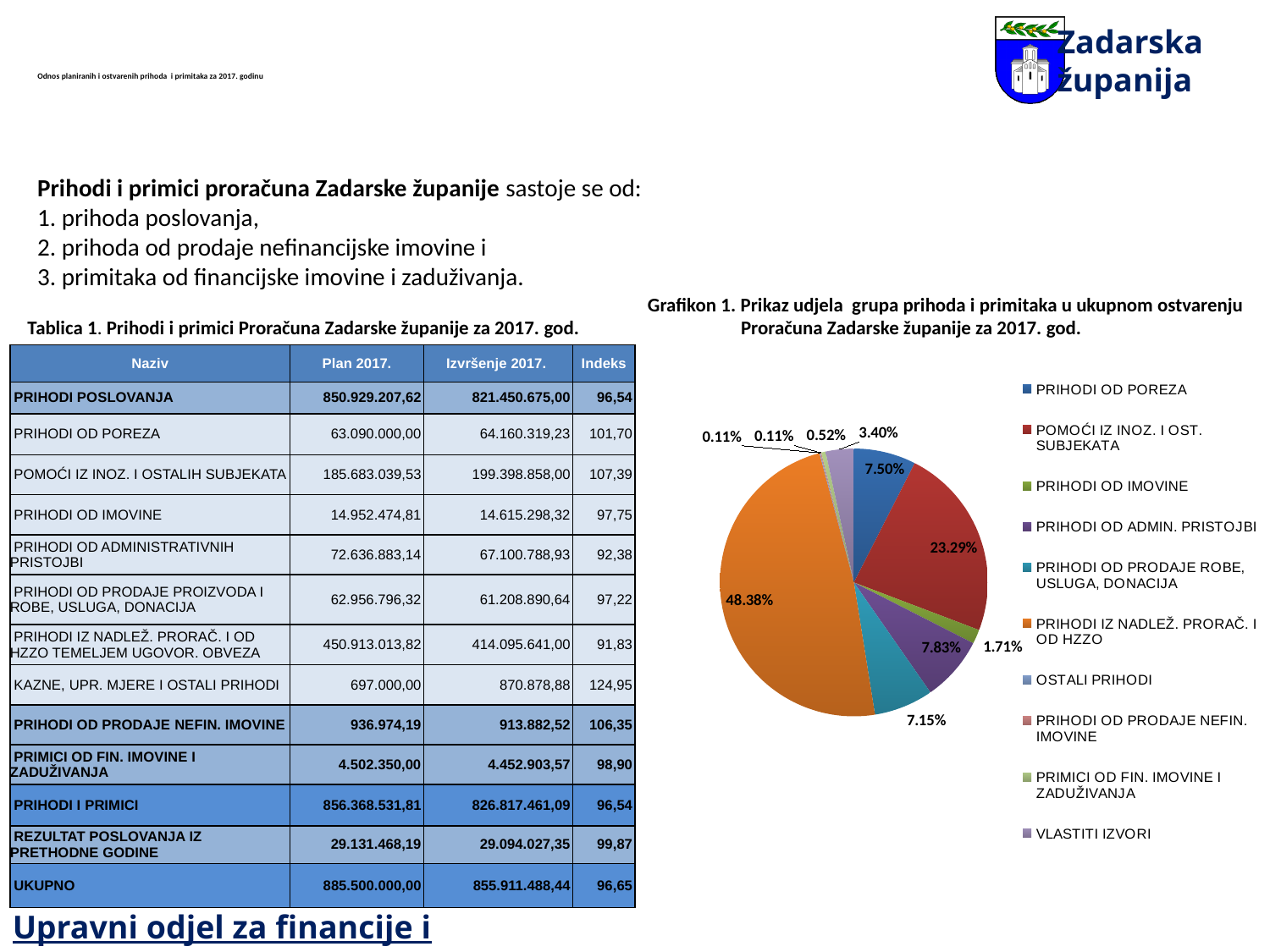
In the pie chart, what share is shown for PRIHODI IZ NADLEŽ. PRORAČ. I OD HZZO? 48.38% What colour is the slice for PRIHODI IZ NADLEŽ. PRORAČ. I OD HZZO in the pie chart? orange Which category has the largest slice in the pie chart? PRIHODI IZ NADLEŽ. PRORAČ. I OD HZZO In the pie chart, which is larger: the share for PRIHODI OD ADMIN. PRISTOJBI or the share for PRIHODI OD PRODAJE ROBE, USLUGA, DONACIJA? PRIHODI OD ADMIN. PRISTOJBI In the pie chart, what share is shown for PRIHODI OD POREZA? 7.50% In the pie chart, what share is shown for PRIHODI OD IMOVINE? 1.71% In the pie chart, what is the difference between the share for PRIHODI IZ NADLEŽ. PRORAČ. I OD HZZO and the share for POMOĆI IZ INOZ. I OST. SUBJEKATA? 25.09% How many categories does the legend of the pie chart list? 10 In the pie chart, what share is shown for PRIHODI OD ADMIN. PRISTOJBI? 7.83% In the pie chart, what share is shown for POMOĆI IZ INOZ. I OST. SUBJEKATA? 23.29% What kind of chart is Grafikon 1 on the slide? pie chart In the pie chart, what share is shown for VLASTITI IZVORI? 3.40%